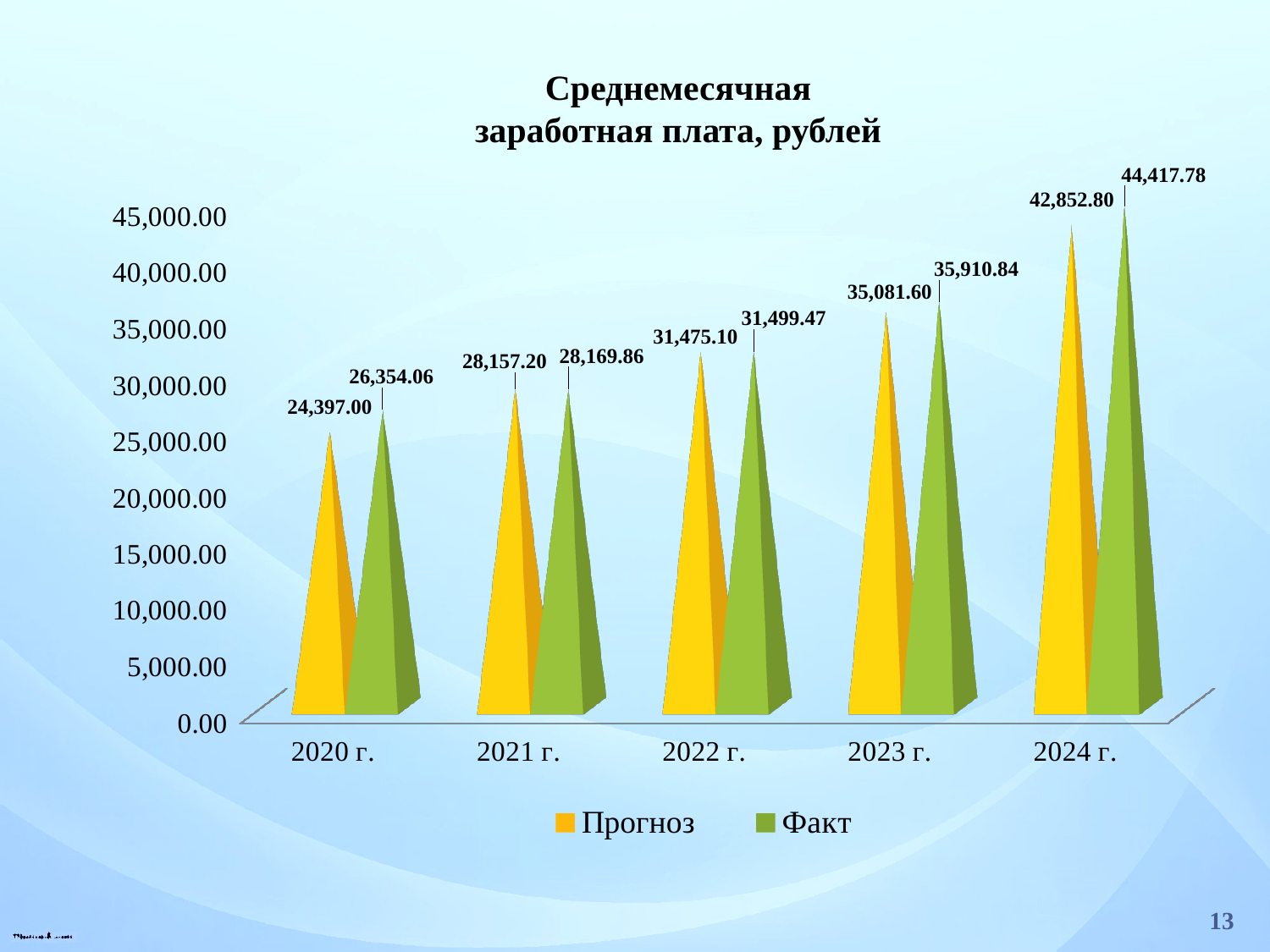
What is the difference between the Факт and Прогноз values for 2024 г.? 1,564.98 What is the difference between the Факт and Прогноз values for 2020 г.? 1,957.06 What is the Факт value for 2024 г.? 44,417.78 Which year has the lowest Прогноз value? 2020 г. What is the Прогноз value for 2023 г.? 35,081.60 For 2024 г., which is larger: Прогноз or Факт? Факт Do the Факт values rise or fall from 2020 г. to 2024 г.? rise What is the Факт value for 2022 г.? 31,499.47 What is the Прогноз value for 2020 г.? 24,397.00 How many series does the legend list? 2 How many years are shown on the x axis? 5 Which year has the highest Факт value? 2024 г.